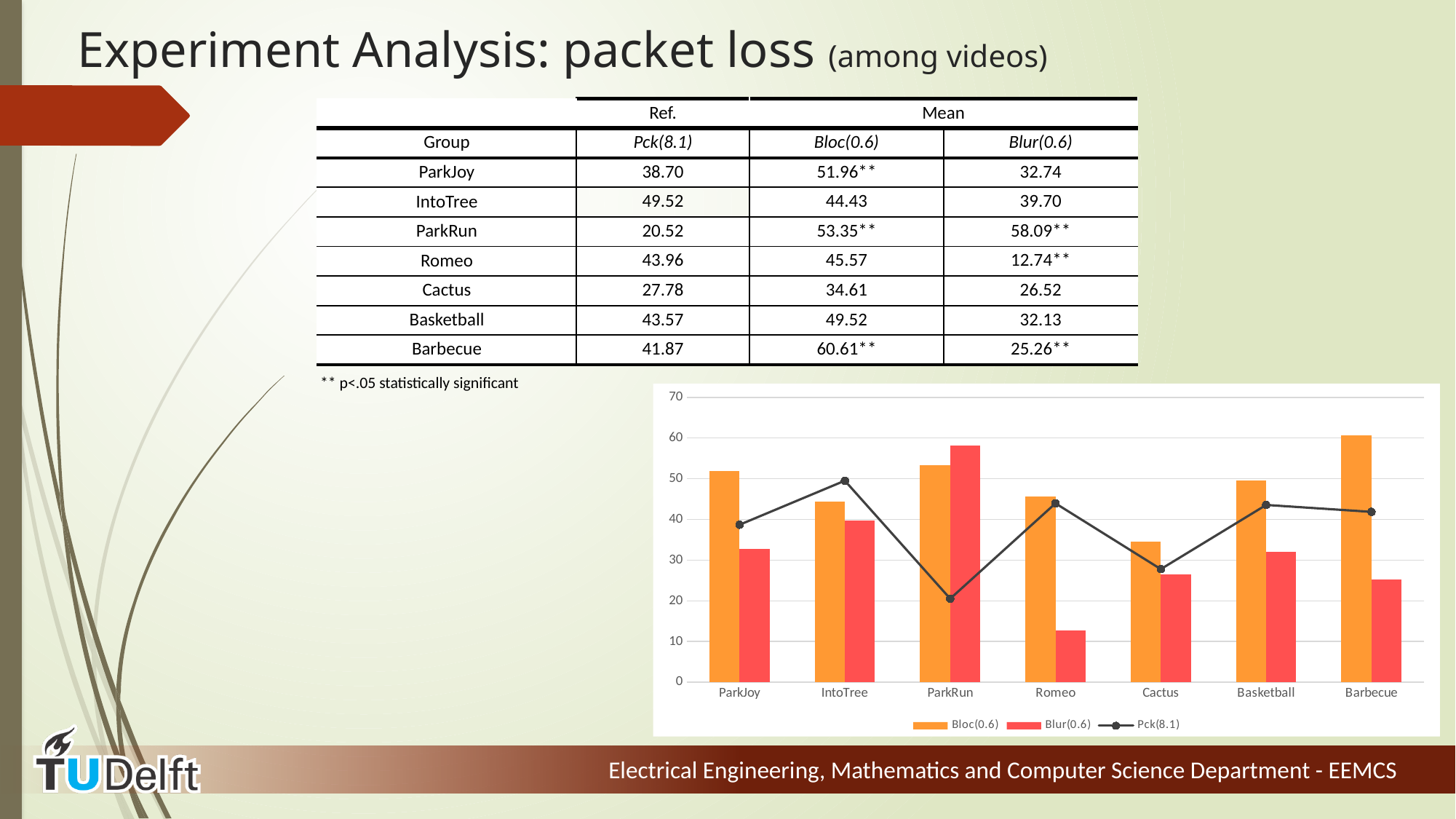
How many series does the chart legend list? 3 What is the difference between the Bloc(0.6) and Blur(0.6) values for Romeo? 32.83 Is the Blur(0.6) value for ParkRun greater or less than 50? greater Which group has the lowest Blur(0.6) bar in the chart? Romeo Which group has the highest Bloc(0.6) bar in the chart? Barbecue Is the Pck(8.1) value for ParkRun greater or less than 30? less What is the Bloc(0.6) mean value for Barbecue? 60.61 Which group has the highest Pck(8.1) point on the line in the chart? IntoTree What kind of chart is shown on the slide? bar chart with a line series How many video groups are shown on the x axis of the chart? 7 For ParkRun, which is larger in the chart: Bloc(0.6) or Blur(0.6)? Blur(0.6) What colour are the Bloc(0.6) bars in the chart? orange